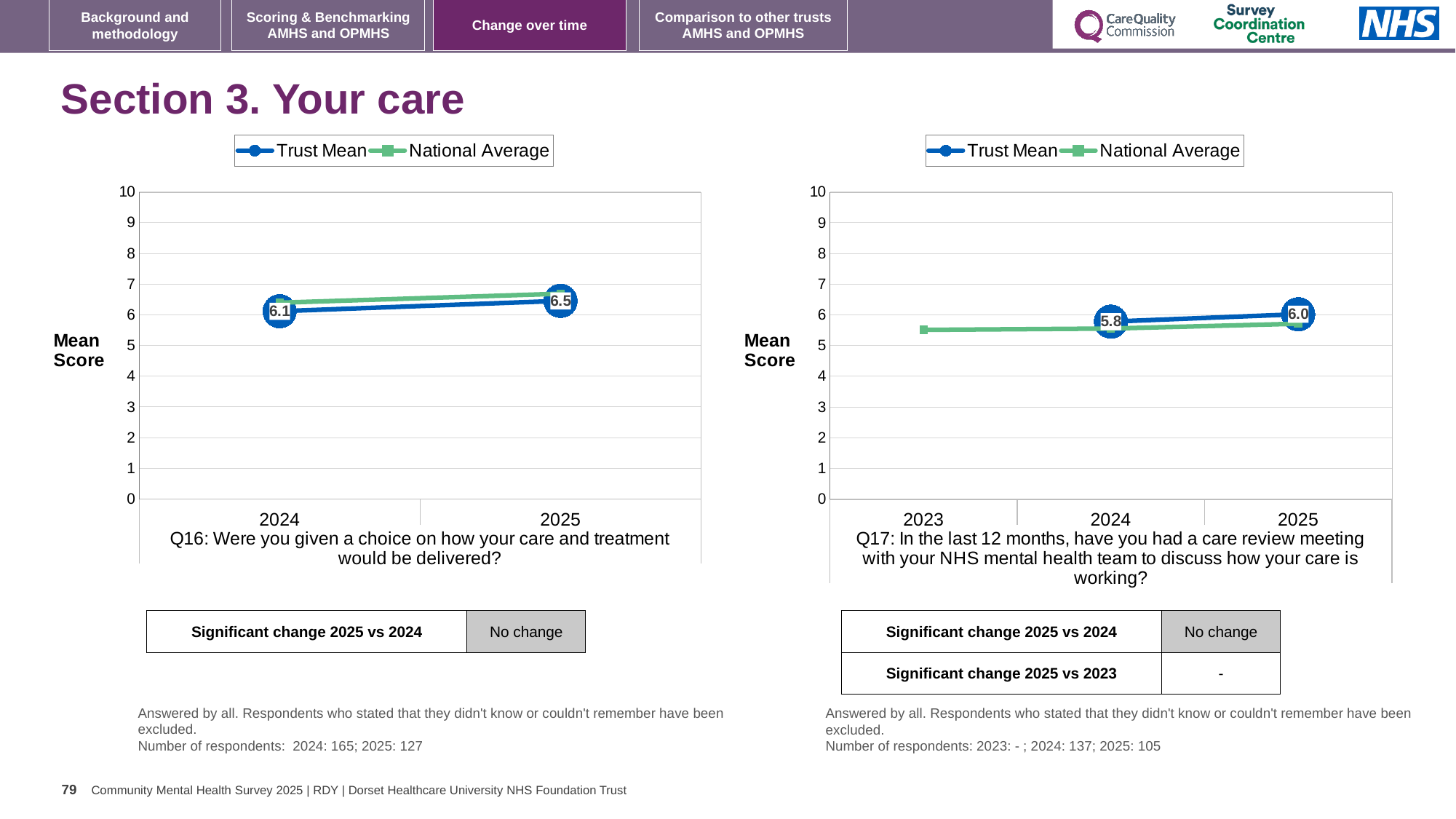
In the right chart (Q17), is the National Average for 2023 greater or less than 6? less In the left chart (Q16), what is the Trust Mean for 2025? 6.5 In the left chart (Q16), does the Trust Mean rise or fall from 2024 to 2025? rise In the right chart (Q17), what is the difference between the Trust Mean in 2025 and in 2024? 0.2 In the left chart (Q16), what is the Trust Mean for 2024? 6.1 How many series does the legend of the left chart (Q16) list? 2 In the left chart (Q16), by how much did the Trust Mean change from 2024 to 2025? 0.4 What type of chart is the right chart (Q17)? line chart What is the label on the y axis of the left chart (Q16)? Mean Score In the right chart (Q17), what is the Trust Mean for 2024? 5.8 In the right chart (Q17), what is the Trust Mean for 2025? 6.0 In the right chart (Q17), how many years are shown on the x axis? 3